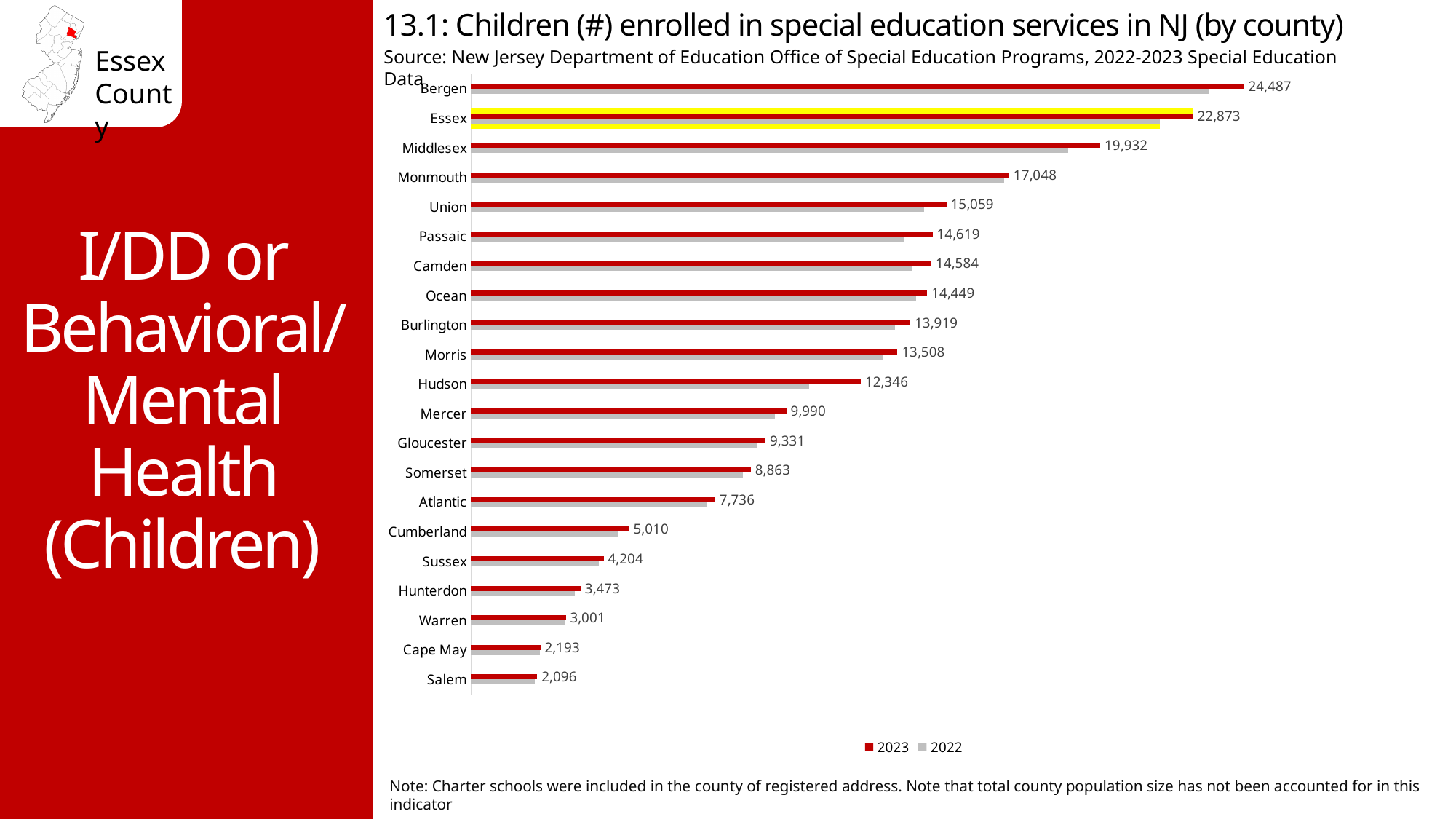
How many series does the legend list? 2 What is the 2023 value for Cape May? 2,193 Which year is represented by the red bars according to the legend? 2023 How many counties are shown in the chart? 21 Which county has the lowest 2023 value? Salem What type of chart is shown on the slide? bar chart What is the difference between the 2023 values for Bergen and Essex? 1,614 Which county has the highest 2023 value? Bergen Which county has a larger 2023 value, Mercer or Gloucester? Mercer What is the 2023 value for Essex? 22,873 What is the 2023 value for Hudson? 12,346 What is the difference between the 2023 values for Cumberland and Sussex? 806